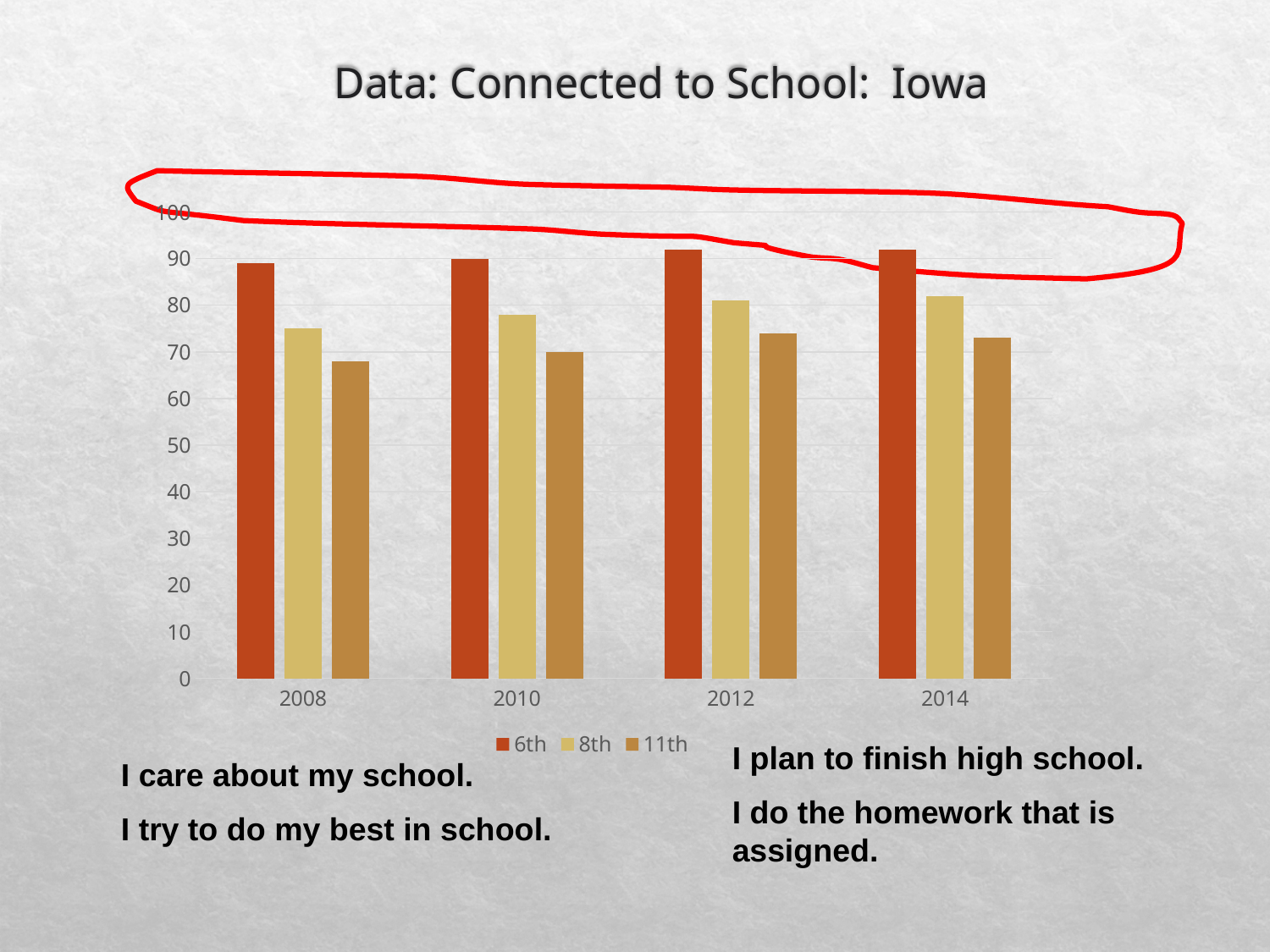
Which is larger, the value for 8th grade in 2008 or the value for 8th grade in 2014? 2014 Is the value for 11th grade in 2008 greater or less than 80? less How many series does the legend list? 3 What kind of chart is shown on the slide? bar chart In 2010, which is larger, the value for 6th grade or the value for 11th grade? 6th grade Is the value for 11th grade in 2012 greater or less than 80? less What is the title of the slide containing the chart? Data: Connected to School: Iowa Which grade has the lowest value in 2008? 11th Which series does the legend list first? 6th Is the value for 8th grade in 2014 greater or less than 70? greater How many years are shown on the x axis? 4